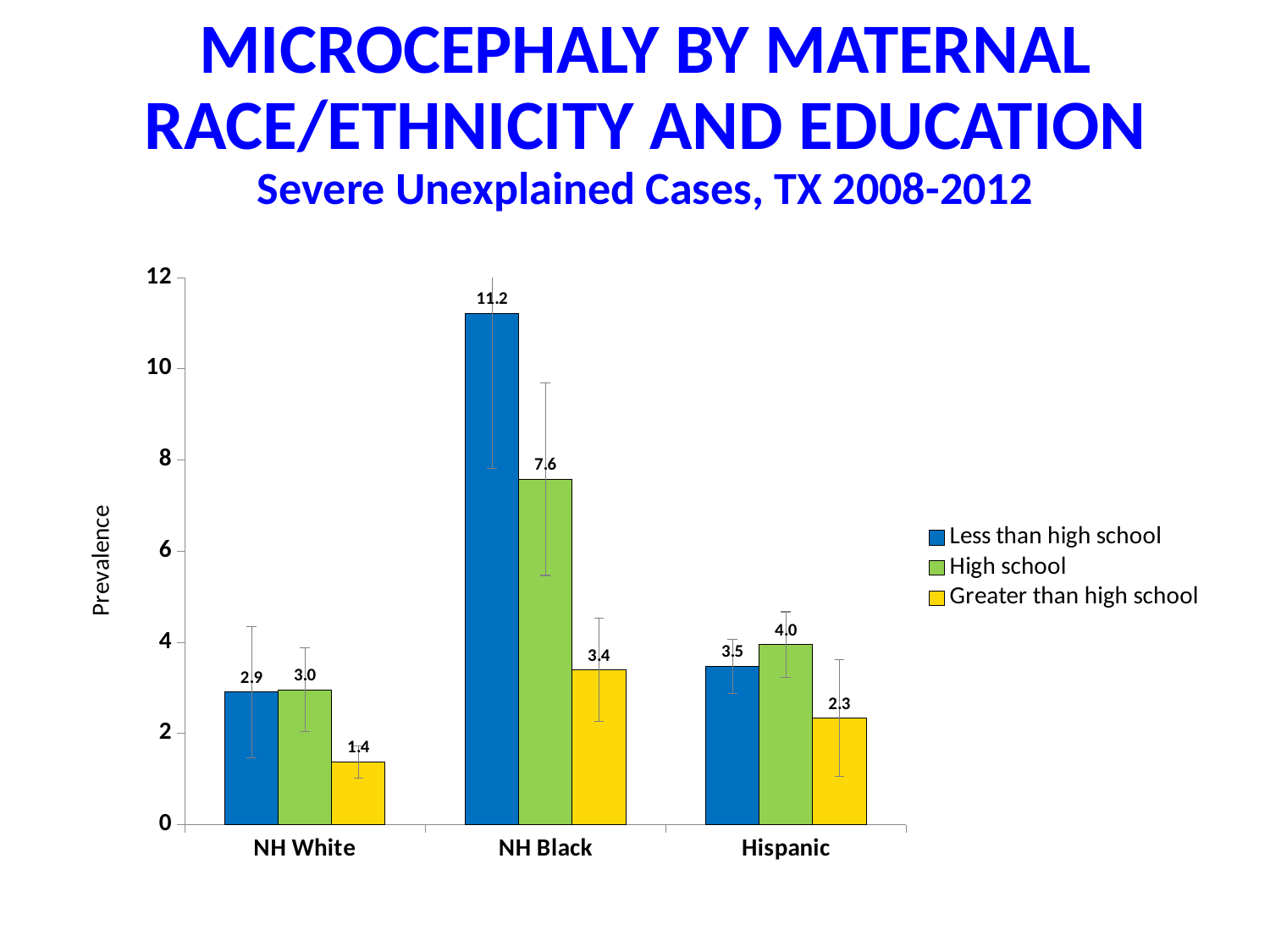
Which race/ethnicity group has the highest prevalence in the Less than high school series? NH Black How many series does the legend list? 3 Is the prevalence for NH Black mothers with high school education greater or less than 6? greater What is the prevalence for Hispanic mothers with greater than high school education? 2.3 What is the difference between the Less than high school and High school prevalence for NH Black mothers? 3.6 Which is larger for Hispanic mothers: the Less than high school prevalence or the High school prevalence? High school Which race/ethnicity group has the lowest prevalence in the Greater than high school series? NH White What is the prevalence for NH Black mothers with less than high school education? 11.2 What is the prevalence for NH White mothers with high school education? 3.0 How many race/ethnicity categories are shown on the x axis? 3 What is the label of the y axis? Prevalence What kind of chart is shown on the slide? Bar chart